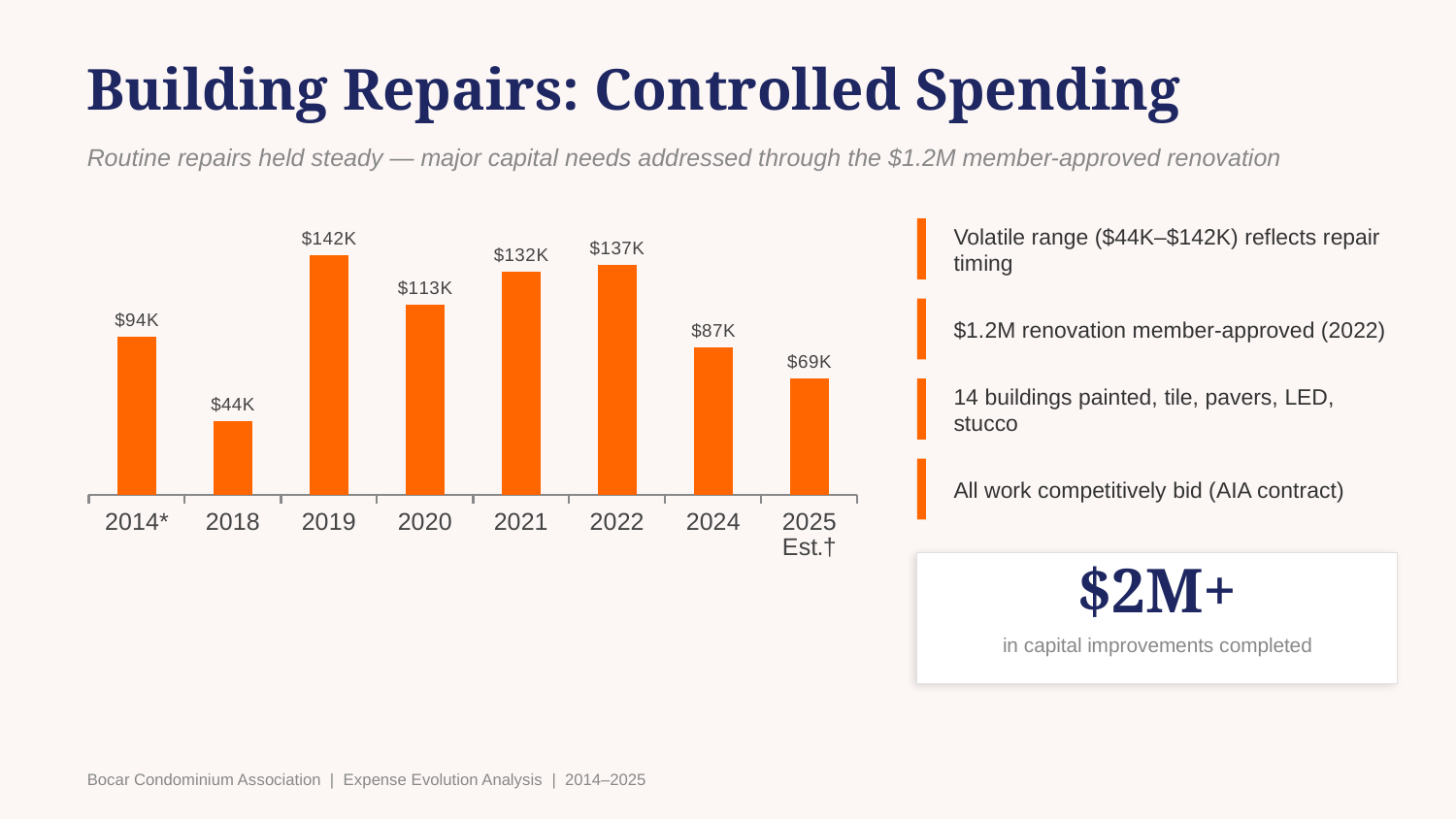
What is the value for 2019? $142K What is the difference between the values for 2022 and 2021? $5K Which year has the lowest value? 2018 What is the value for 2025 Est.? $69K Do the values rise or fall from 2022 to 2025 Est.? fall Which is larger, the value for 2020 or the value for 2024? 2020 Which year has the highest value? 2019 What colour are the bars in the chart? orange What kind of chart is shown on the slide? bar chart How many bars are shown in the chart? 8 What is the value for 2018? $44K What is the difference between the values for 2019 and 2018? $98K